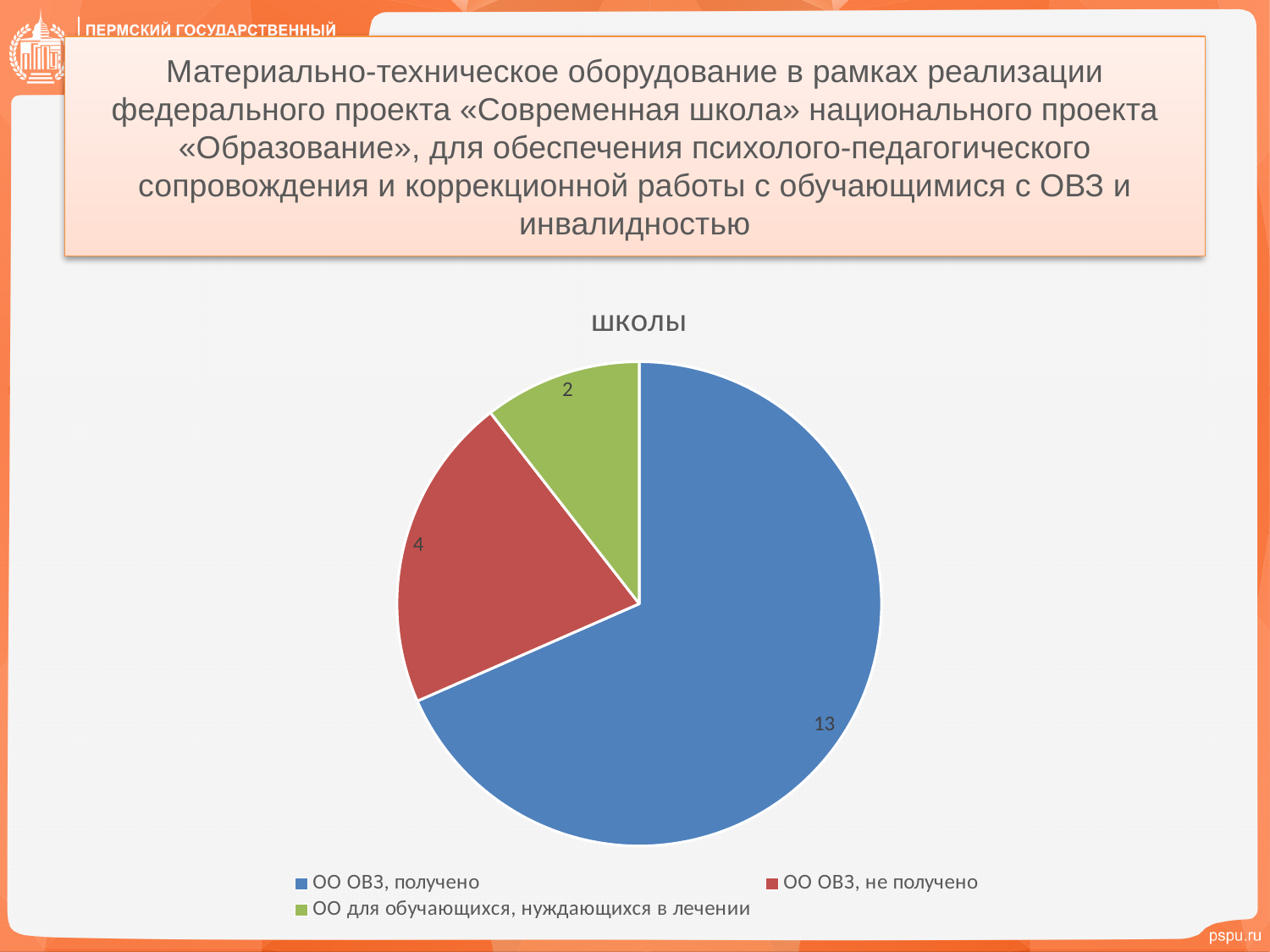
How many entries does the legend list? 3 What kind of chart is shown on the slide? Pie chart Which category has the smallest slice? ОО для обучающихся, нуждающихся в лечении Which category has the largest slice? ОО ОВЗ, получено What is the value for "ОО ОВЗ, не получено"? 4 What is the value for "ОО ОВЗ, получено"? 13 Which is larger: "ОО ОВЗ, не получено" or "ОО для обучающихся, нуждающихся в лечении"? ОО ОВЗ, не получено What is the title of the chart? школы What is the value for "ОО для обучающихся, нуждающихся в лечении"? 2 What is the difference between the values for "ОО ОВЗ, получено" and "ОО ОВЗ, не получено"? 9 What is the total of all slices in the pie chart? 19 How many slices does the pie chart have? 3